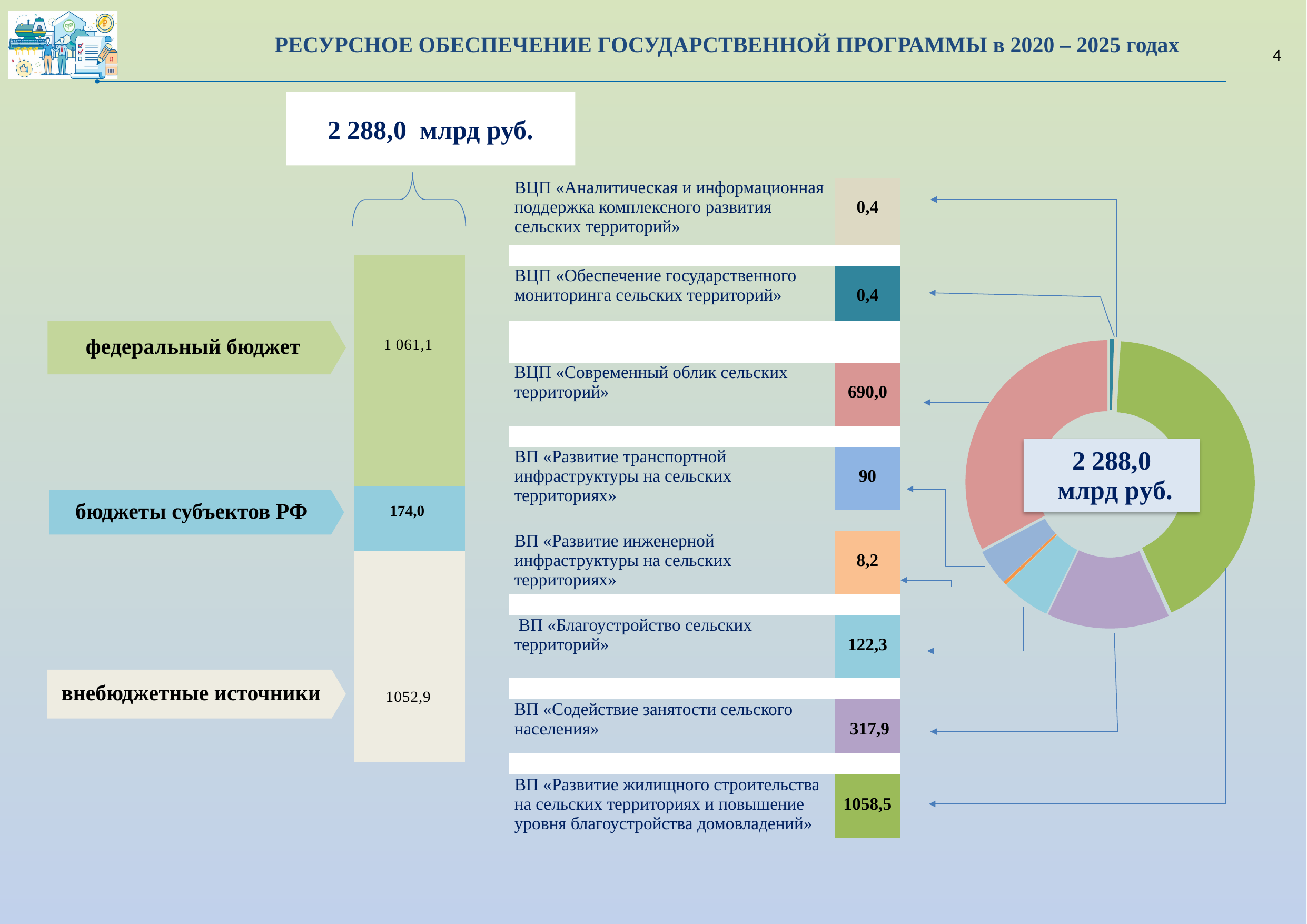
In the stacked bar on the left, what is the value for внебюджетные источники? 1052,9 In the stacked bar on the left, what is the value for бюджеты субъектов РФ? 174,0 How many segments does the stacked bar on the left have? 3 What kind of chart is shown on the right of the slide? Donut (pie) chart What total is shown above the stacked bar on the left? 2 288,0 млрд руб. In the stacked bar on the left, what is the difference between федеральный бюджет and бюджеты субъектов РФ? 887,1 In the stacked bar on the left, which is larger: федеральный бюджет or внебюджетные источники? федеральный бюджет In the stacked bar on the left, which source has the smallest value? бюджеты субъектов РФ In the donut chart on the right, what is the value for ВП «Развитие жилищного строительства на сельских территориях и повышение уровня благоустройства домовладений»? 1058,5 In the stacked bar on the left, what is the value for федеральный бюджет? 1 061,1 In the donut chart on the right, what is the value for ВП «Содействие занятости сельского населения»? 317,9 In the donut chart on the right, which programme has the largest value? ВП «Развитие жилищного строительства на сельских территориях и повышение уровня благоустройства домовладений»